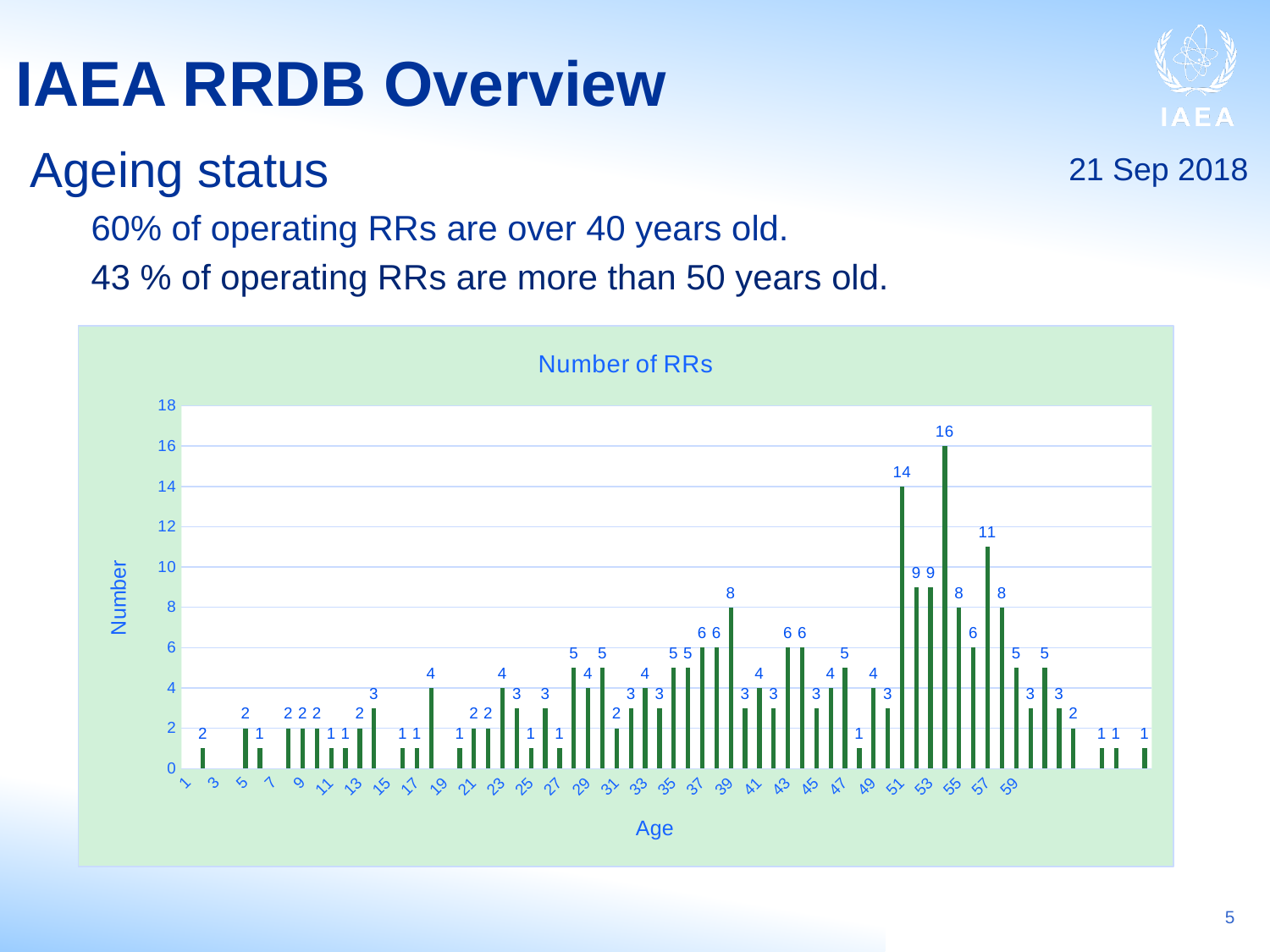
What is the smallest value shown by any bar in the chart? 1 What is the title of the chart? Number of RRs What kind of chart is shown on the slide? bar chart What is the label of the vertical axis of the chart? Number What is the second highest value shown by any bar in the chart? 14 Which is larger, the bar labelled 11 or the bar labelled 14? 14 What is the difference between the tallest bar (16) and the second tallest bar (14)? 2 What is the highest value shown by any bar in the chart? 16 How many bars in the chart have a value of 9? 2 Is the tallest bar in the chart greater or less than 14? greater Are the tallest bars in the chart found at younger ages or older ages along the Age axis? older ages How many bars in the chart reach a value of 16? 1